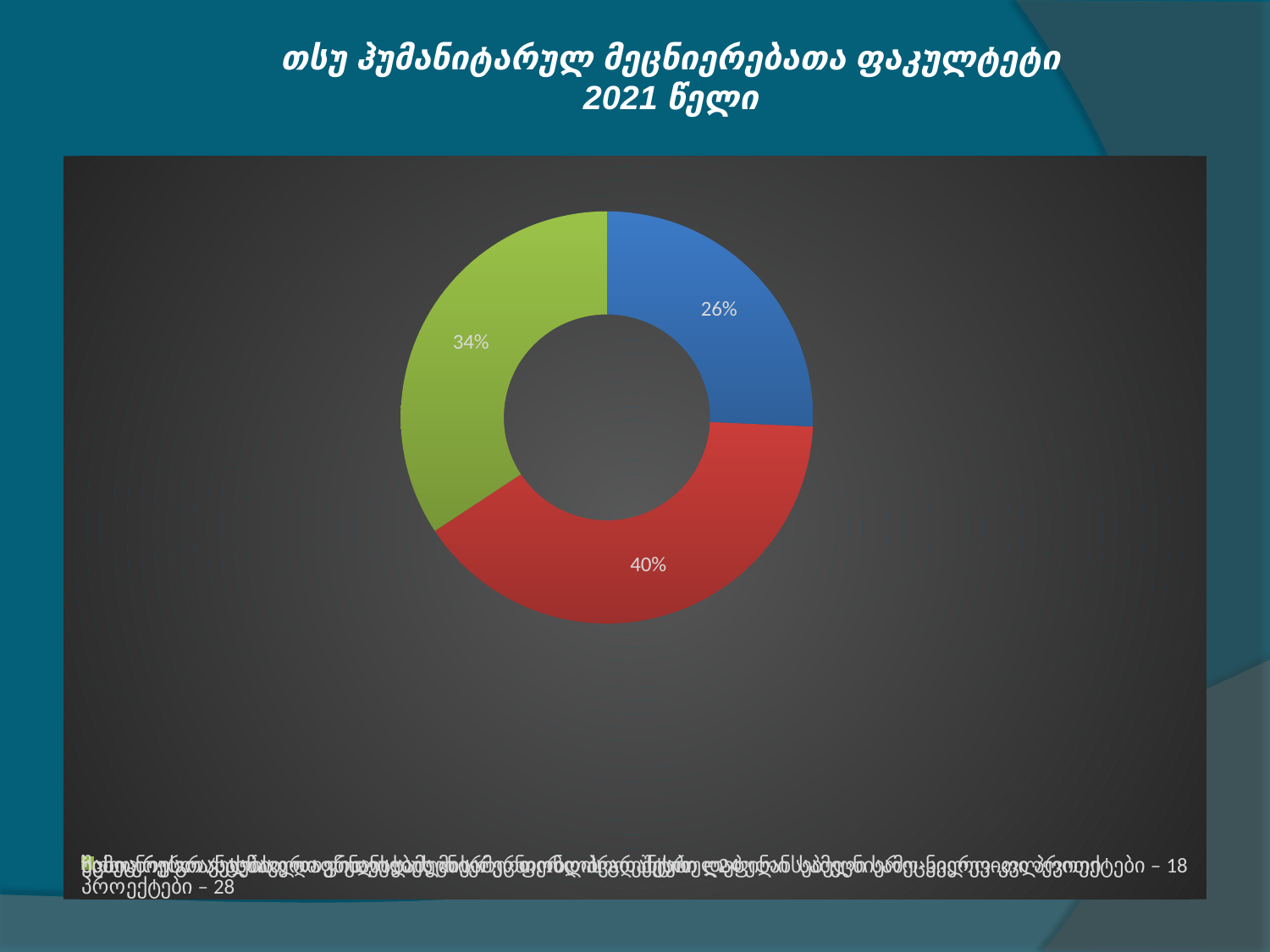
What do the three slice percentages add up to? 100% What year is mentioned in the slide title? 2021 How many slices does the doughnut chart have? 3 What is the difference in percentage points between the red slice and the blue slice? 14 Which colour slice has the largest share in the doughnut chart? red What is the difference in percentage points between the green slice and the blue slice? 8 Which is larger, the green slice or the blue slice? green What percentage is shown on the red slice of the doughnut chart? 40% What percentage is shown on the green slice of the doughnut chart? 34% What kind of chart is shown on the slide? doughnut (pie) chart What percentage is shown on the blue slice of the doughnut chart? 26% Which colour slice has the smallest share in the doughnut chart? blue